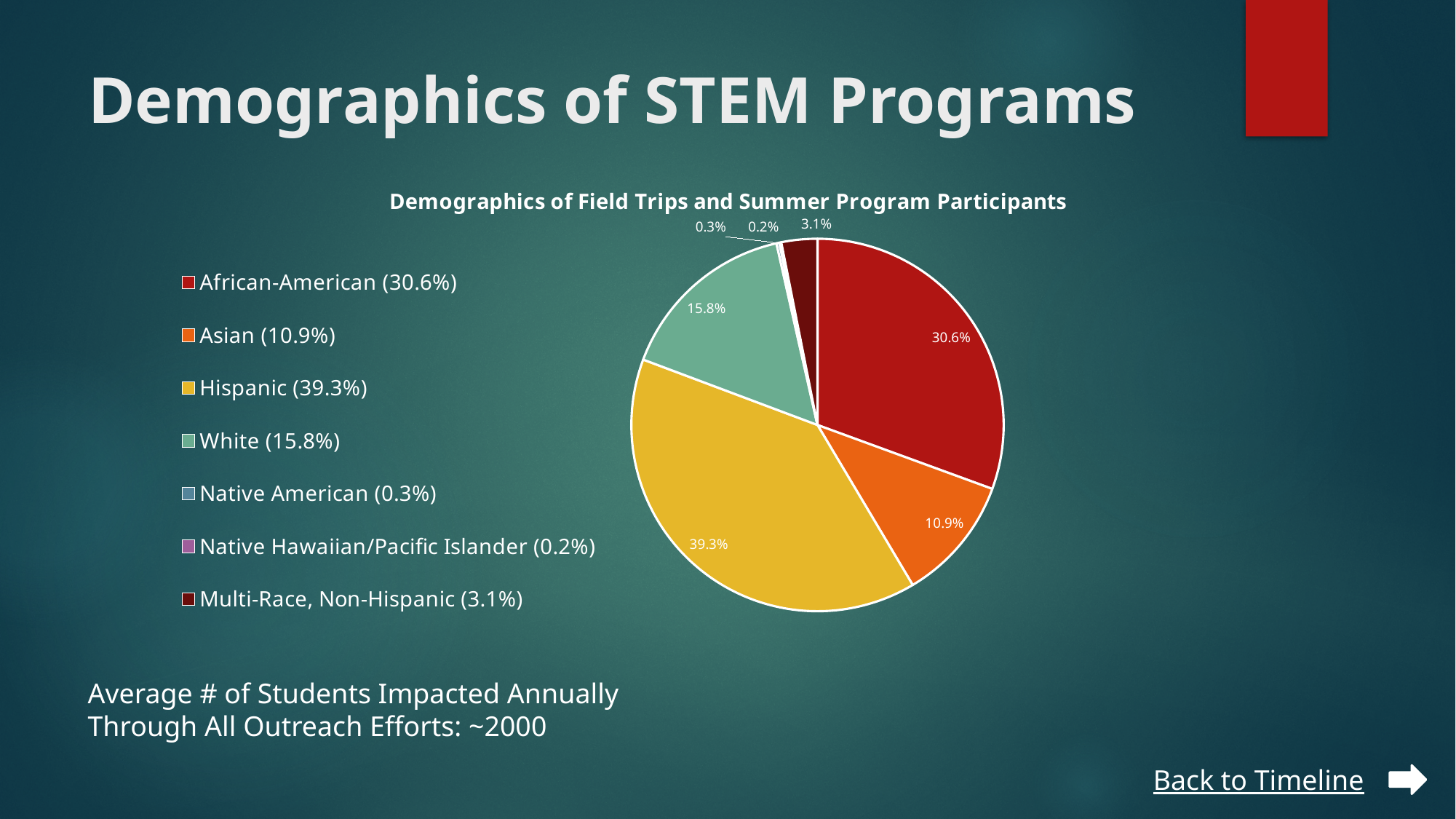
What is the difference between the Hispanic and African-American percentages? 8.7% What percentage of participants are Native Hawaiian/Pacific Islander? 0.2% Which category has the largest share of the pie? Hispanic What is the title of the chart? Demographics of Field Trips and Summer Program Participants What type of chart is shown on the slide? Pie chart What percentage of participants are White? 15.8% What percentage of participants are African-American? 30.6% How many categories does the pie chart have? 7 What is the combined percentage of Asian and Multi-Race, Non-Hispanic participants? 14.0% What percentage of participants are Hispanic? 39.3% Which category has the smallest share of the pie? Native Hawaiian/Pacific Islander Which is larger, the Asian share or the White share? White